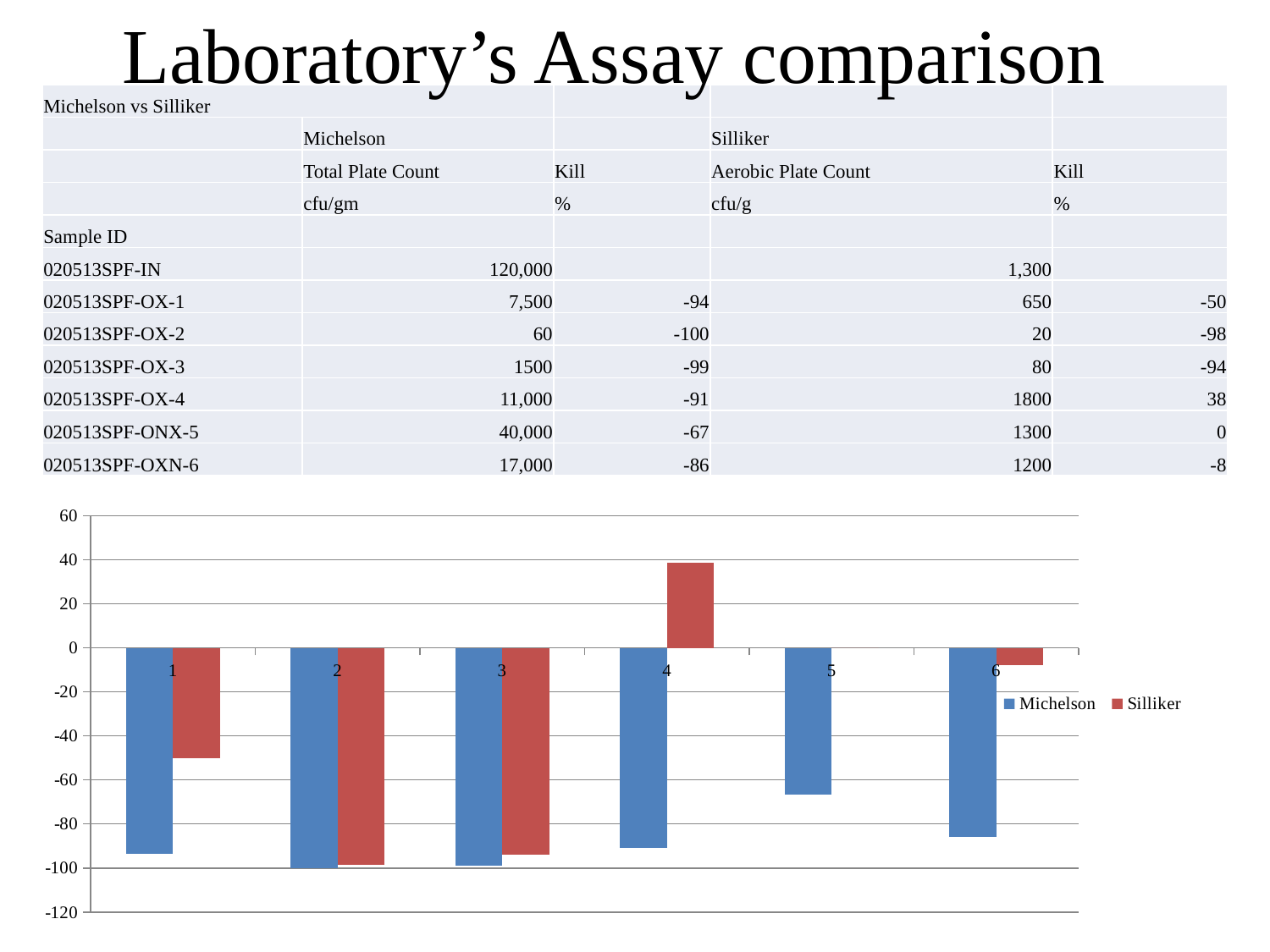
For category 4, which series has the larger value, Michelson or Silliker? Silliker Is the Michelson value for category 6 greater or less than -80? less How many series does the chart legend list? 2 Is the Silliker value for category 1 greater or less than -40? less How many categories are shown along the x axis of the chart? 6 What is the Michelson value for category 2 in the chart? -100 What are the two series named in the chart legend? Michelson and Silliker Is the Michelson value for category 5 greater or less than -60? less What kind of chart is shown on the slide? bar chart Which category has the highest Michelson value in the chart? 5 Which category has the highest Silliker value in the chart? 4 What is the lowest value shown on the vertical axis of the chart? -120